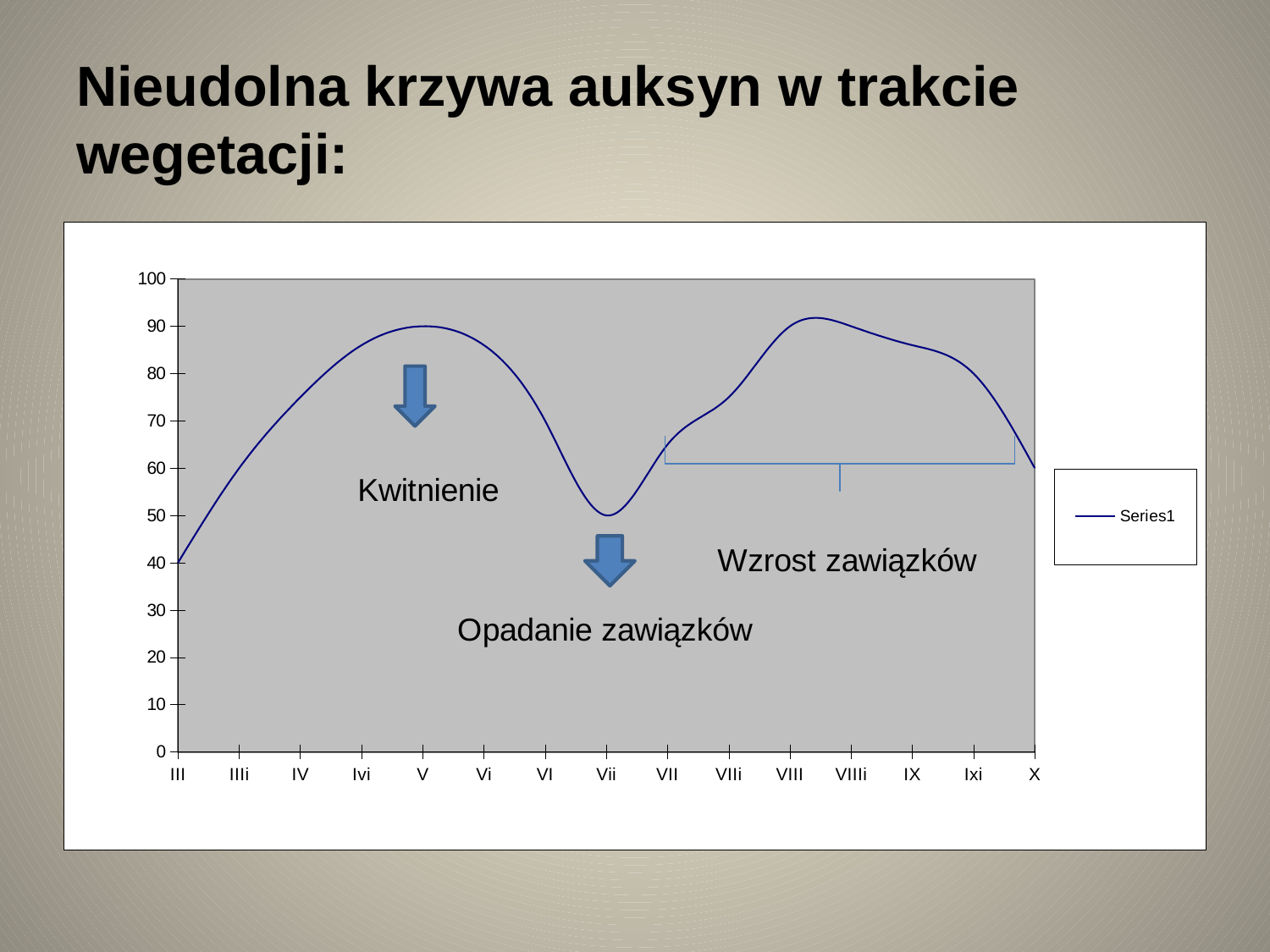
Is the value for IX greater or less than 70? greater What kind of chart is shown on the slide? line chart Which category has the lowest value on the line? III How many categories are shown on the x axis? 15 How many series does the legend list? 1 Is the value for IV greater or less than 60? greater What is the name of the series shown in the legend? Series1 Is the value for VIII greater or less than 80? greater Do the values rise or fall from III to V? rise